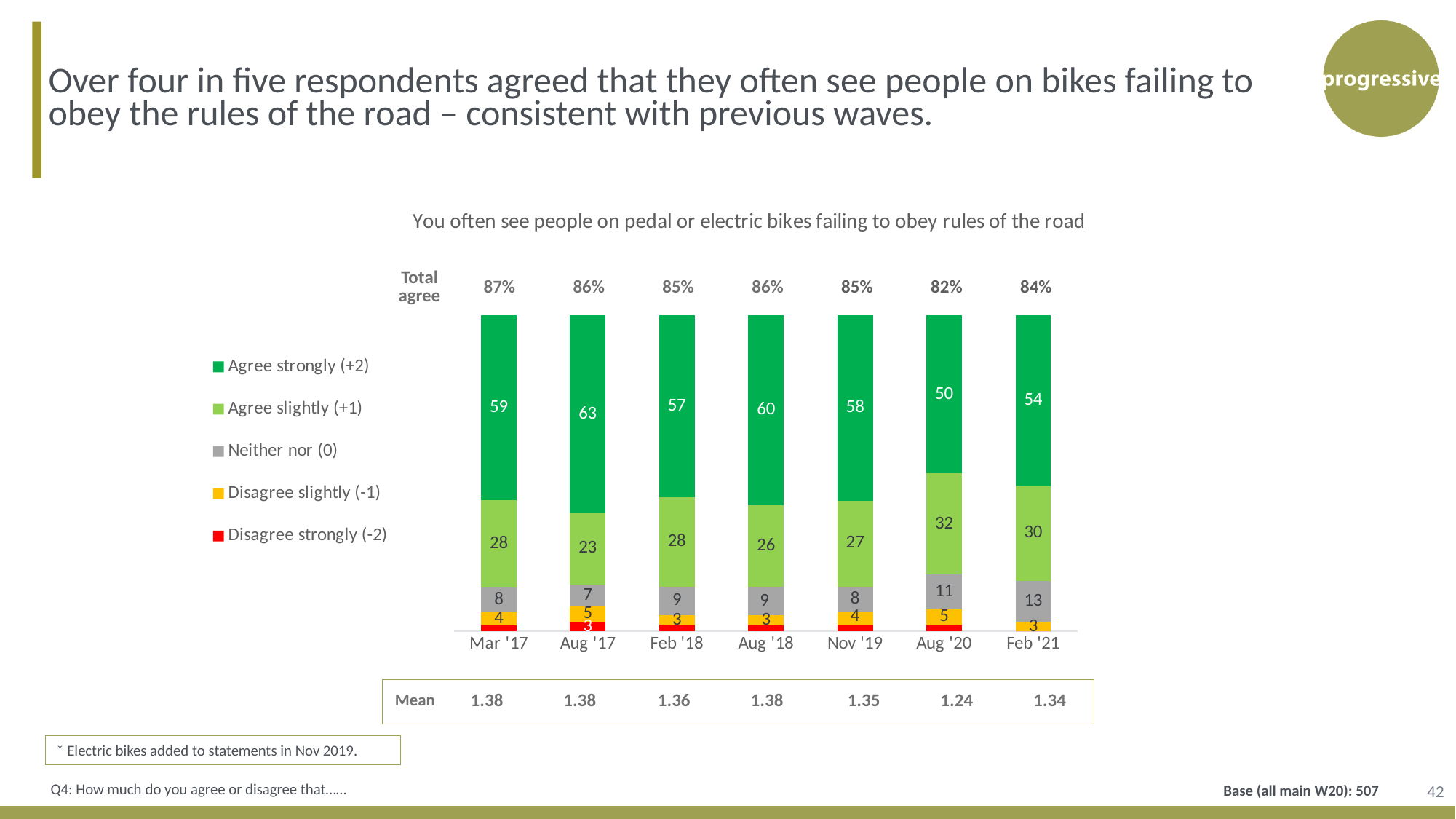
Which wave has the lowest Agree strongly (+2) value? Aug '20 What is the Total agree figure shown for Aug '20? 82% What is the value for Neither nor (0) in Feb '21? 13 How many series does the legend list? 5 Which wave has the highest Agree strongly (+2) value? Aug '17 Which is larger, the Agree slightly (+1) value for Mar '17 or for Aug '17? Mar '17 What kind of chart is shown on the slide? Stacked bar chart How many waves (categories) are shown on the x axis? 7 What is the Mean value shown for Aug '20? 1.24 What is the difference between the Agree strongly (+2) values for Aug '17 and Aug '20? 13 What is the value for Agree slightly (+1) in Aug '20? 32 What is the value for Agree strongly (+2) in Aug '17? 63